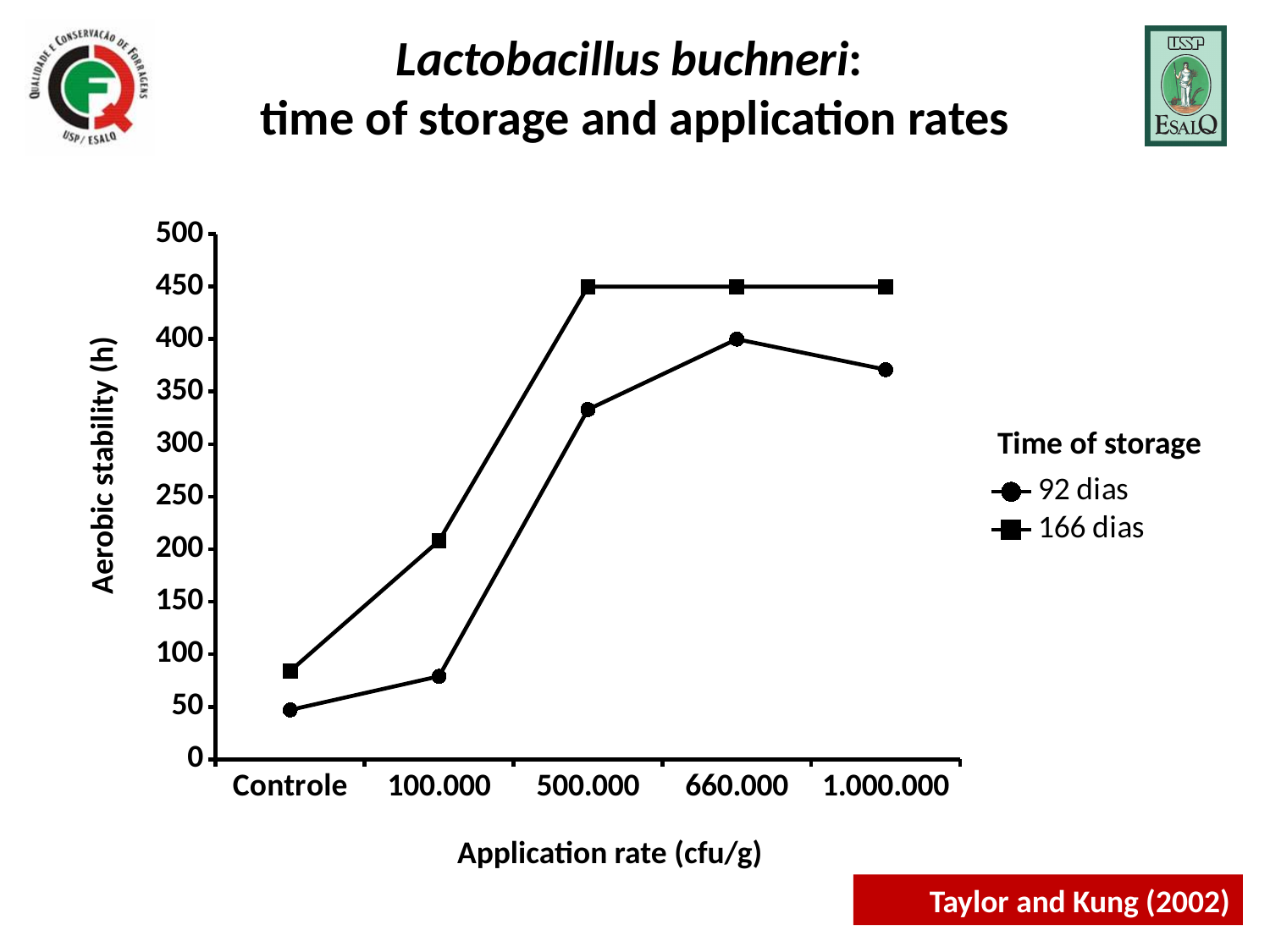
Is the value for 92 dias at Controle greater or less than 100? less How many application rate categories are shown on the x axis? 5 How many series does the legend list? 2 What is the aerobic stability for 92 dias at an application rate of 660.000 cfu/g? 400 At which application rate is the aerobic stability for 92 dias lowest? Controle What is the title of the legend? Time of storage What is the aerobic stability for 166 dias at an application rate of 500.000 cfu/g? 450 What is the label of the y axis? Aerobic stability (h) What kind of chart is shown on the slide? line chart Is the value for 92 dias at 500.000 cfu/g greater or less than 300? greater Which series has the higher aerobic stability at 1.000.000 cfu/g, 92 dias or 166 dias? 166 dias